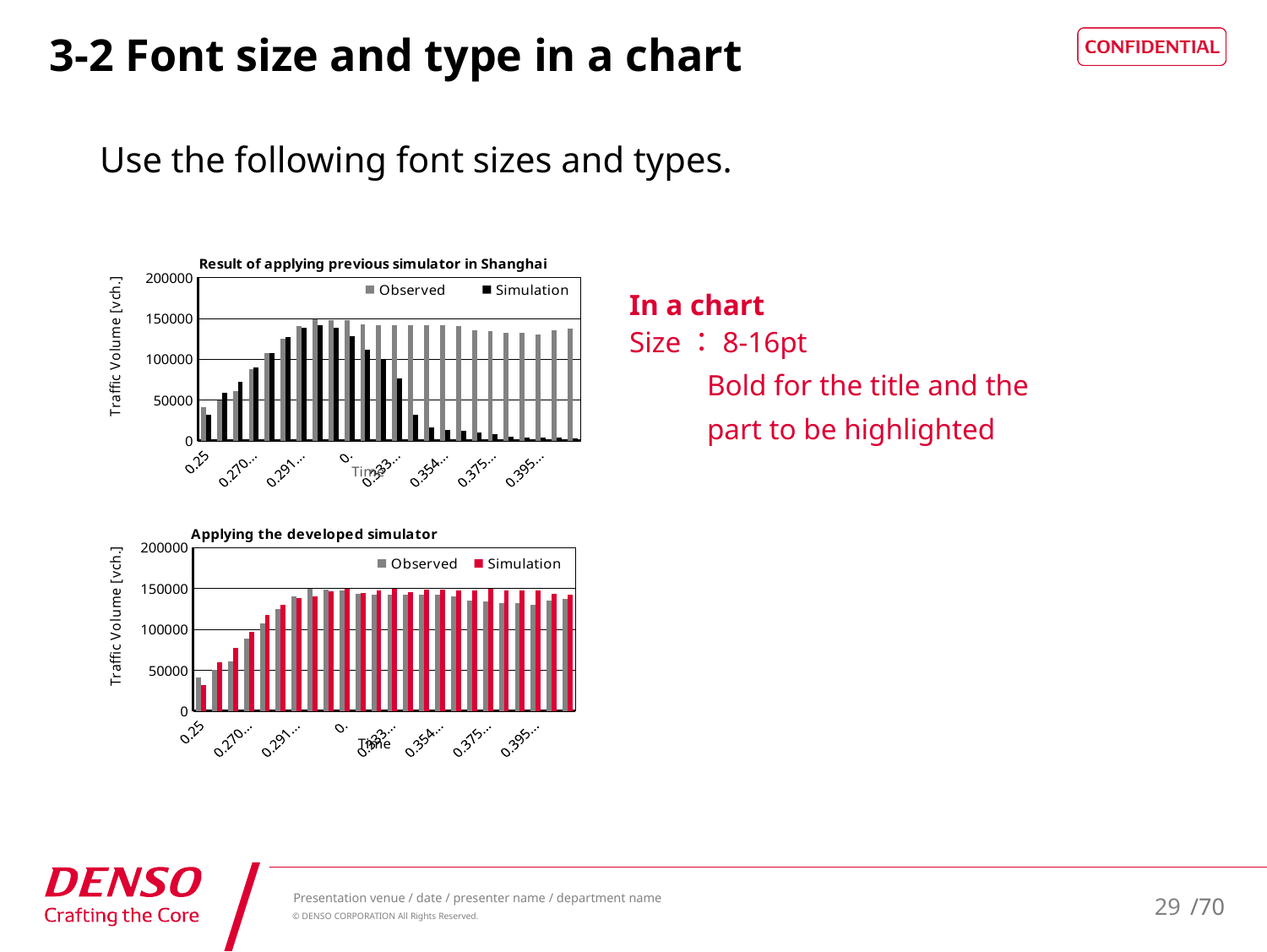
In the bottom chart, is the Observed value at 0.354... greater or less than 100000? greater How many series does the legend of the bottom chart list? 2 In the top chart, is the Simulation value at 0.395... greater or less than 50000? less What is the title of the top chart? Result of applying previous simulator in Shanghai In the bottom chart, which is larger at 0.25, the Observed value or the Simulation value? Observed In the bottom chart, is the Simulation value at 0.25 greater or less than 50000? less How many series does the legend of the top chart list? 2 What kind of chart is the bottom chart titled "Applying the developed simulator"? bar chart What is the y-axis label of the bottom chart? Traffic Volume [vch.] In the top chart, which is larger at 0.395..., the Observed value or the Simulation value? Observed What kind of chart is the top chart titled "Result of applying previous simulator in Shanghai"? bar chart